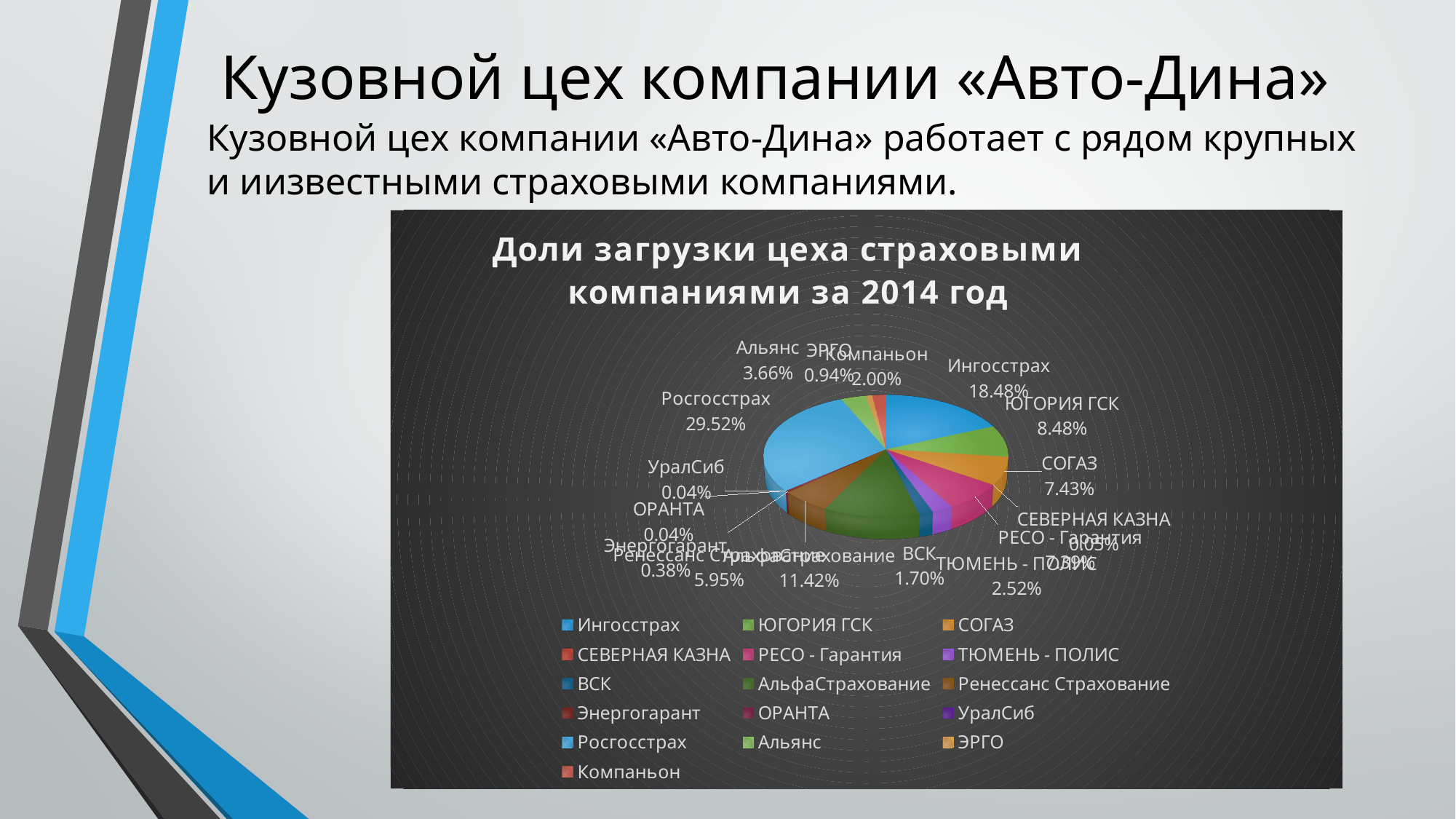
Which has a larger share, Ингосстрах or АльфаСтрахование? Ингосстрах What share does Альянс have in the pie chart? 3.66% What kind of chart is shown on the slide? Pie chart What share does Ренессанс Страхование have in the pie chart? 5.95% How many insurance companies are listed in the chart legend? 16 What share does Росгосстрах have in the pie chart? 29.52% What share does Ингосстрах have in the pie chart? 18.48% Which insurance company has the largest share in the pie chart? Росгосстрах What share does АльфаСтрахование have in the pie chart? 11.42% What share does ЮГОРИЯ ГСК have in the pie chart? 8.48% What is the difference between the shares of Росгосстрах and Ингосстрах? 11.04% What is the title of the chart? Доли загрузки цеха страховыми компаниями за 2014 год